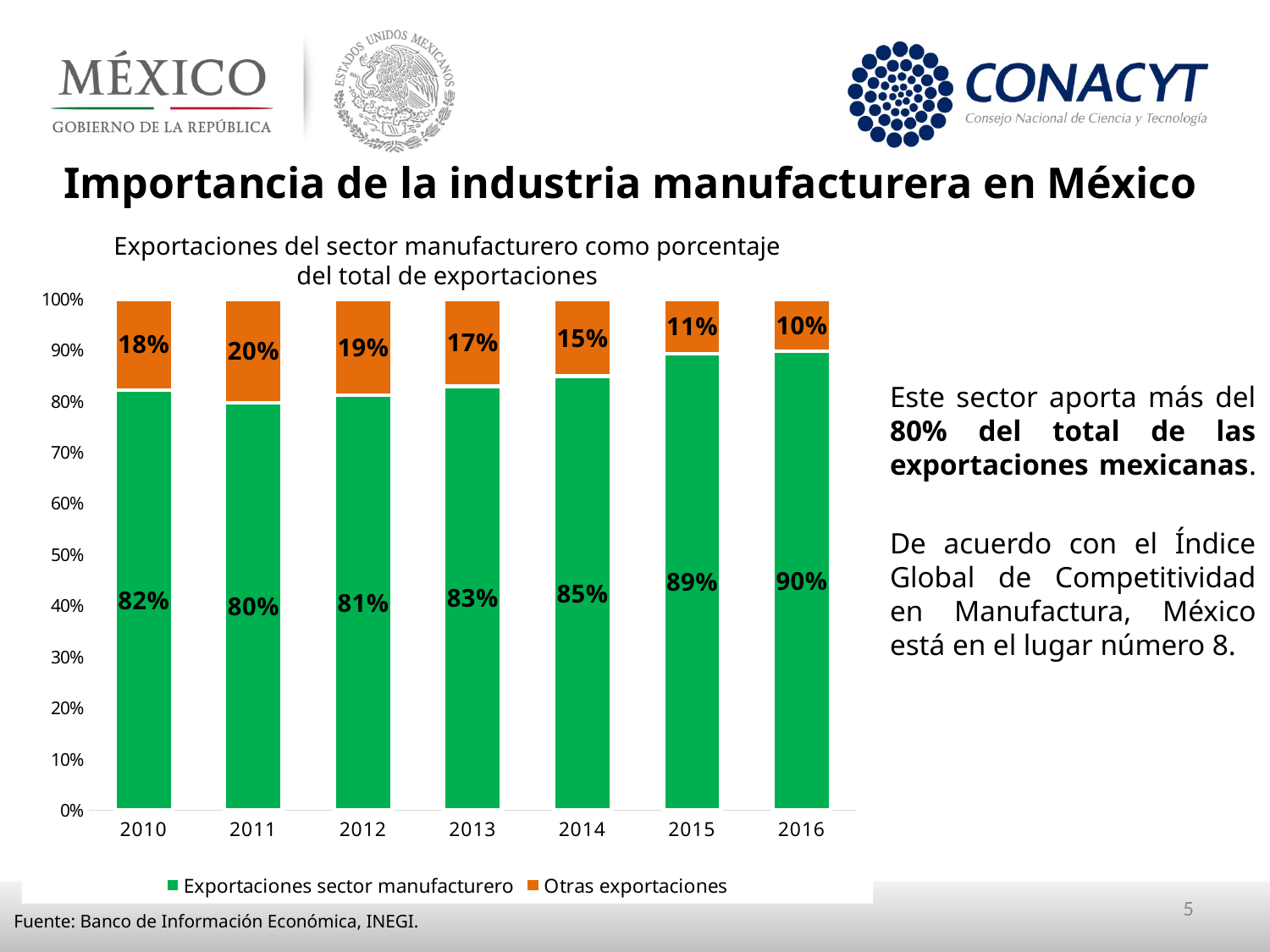
What kind of chart is shown on the slide? Stacked bar chart Which is larger, the Otras exportaciones value for 2012 or for 2014? 2012 Which year has the highest value for Exportaciones sector manufacturero? 2016 Which year has the lowest value for Exportaciones sector manufacturero? 2011 What is the difference between the Exportaciones sector manufacturero values for 2016 and 2010? 8% Does the value for Otras exportaciones rise or fall from 2011 to 2016? Fall What is the value for Exportaciones sector manufacturero in 2014? 85% What is the value for Exportaciones sector manufacturero in 2016? 90% Which year has the highest value for Otras exportaciones? 2011 What is the value for Otras exportaciones in 2011? 20% How many years are shown on the x axis? 7 How many series does the legend list? 2